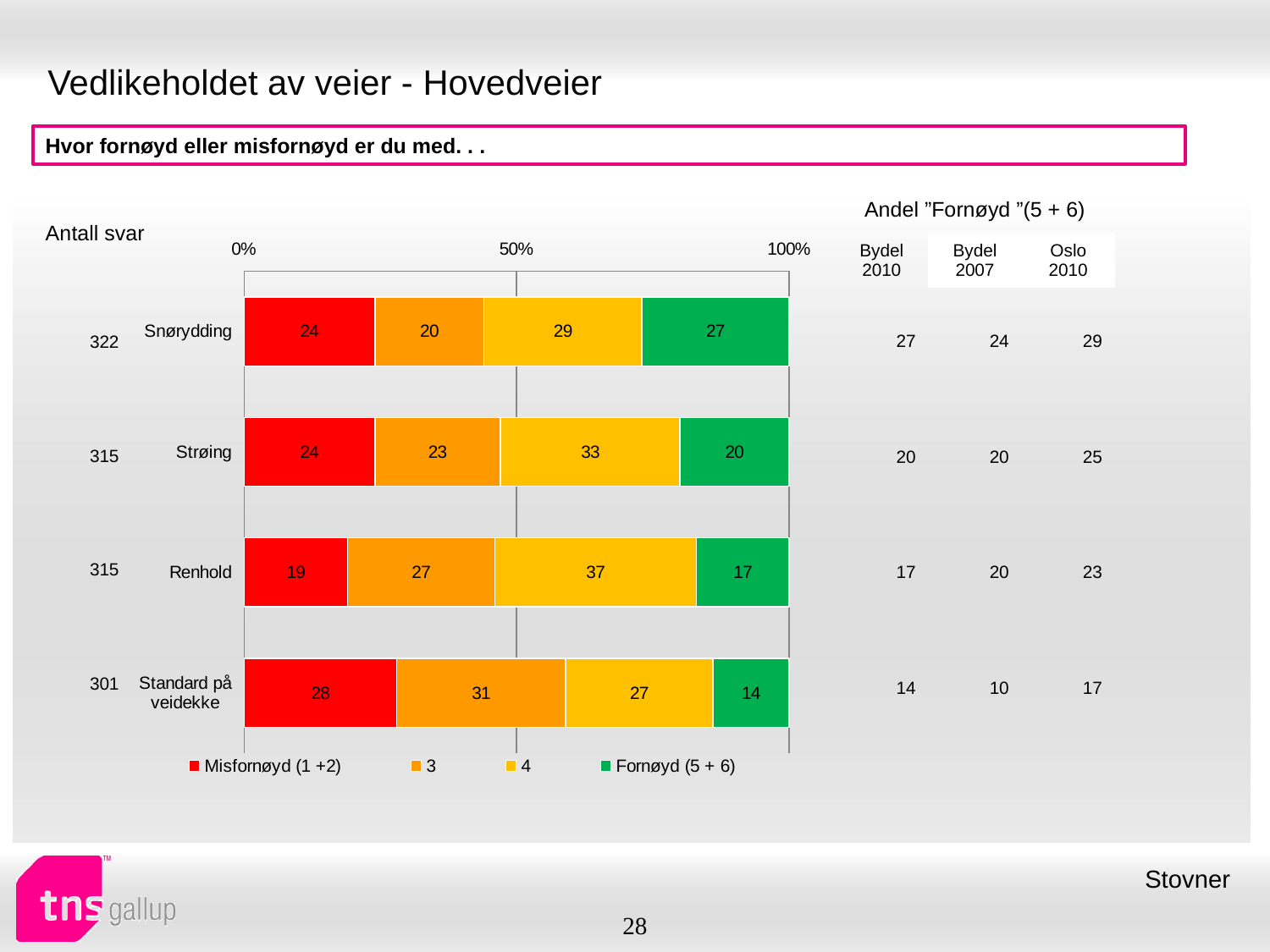
What is the total of the stacked bar for Strøing? 100 How many categories are plotted in the chart? 4 What is the value of the 'Misfornøyd (1 +2)' series for Standard på veidekke? 28 Which category has the highest value for the 'Fornøyd (5 + 6)' series? Snørydding How many series does the chart legend list? 4 Which category has the lowest value for the 'Fornøyd (5 + 6)' series? Standard på veidekke Which series is shown in green in the chart? Fornøyd (5 + 6) Which is larger: the 'Misfornøyd (1 +2)' value for Strøing or for Renhold? Strøing What kind of chart is shown on the slide? Stacked bar chart What is the value of the 'Fornøyd (5 + 6)' series for Snørydding? 27 What is the difference between the 'Fornøyd (5 + 6)' values for Snørydding and Standard på veidekke? 13 What is the value of series '4' for Renhold? 37